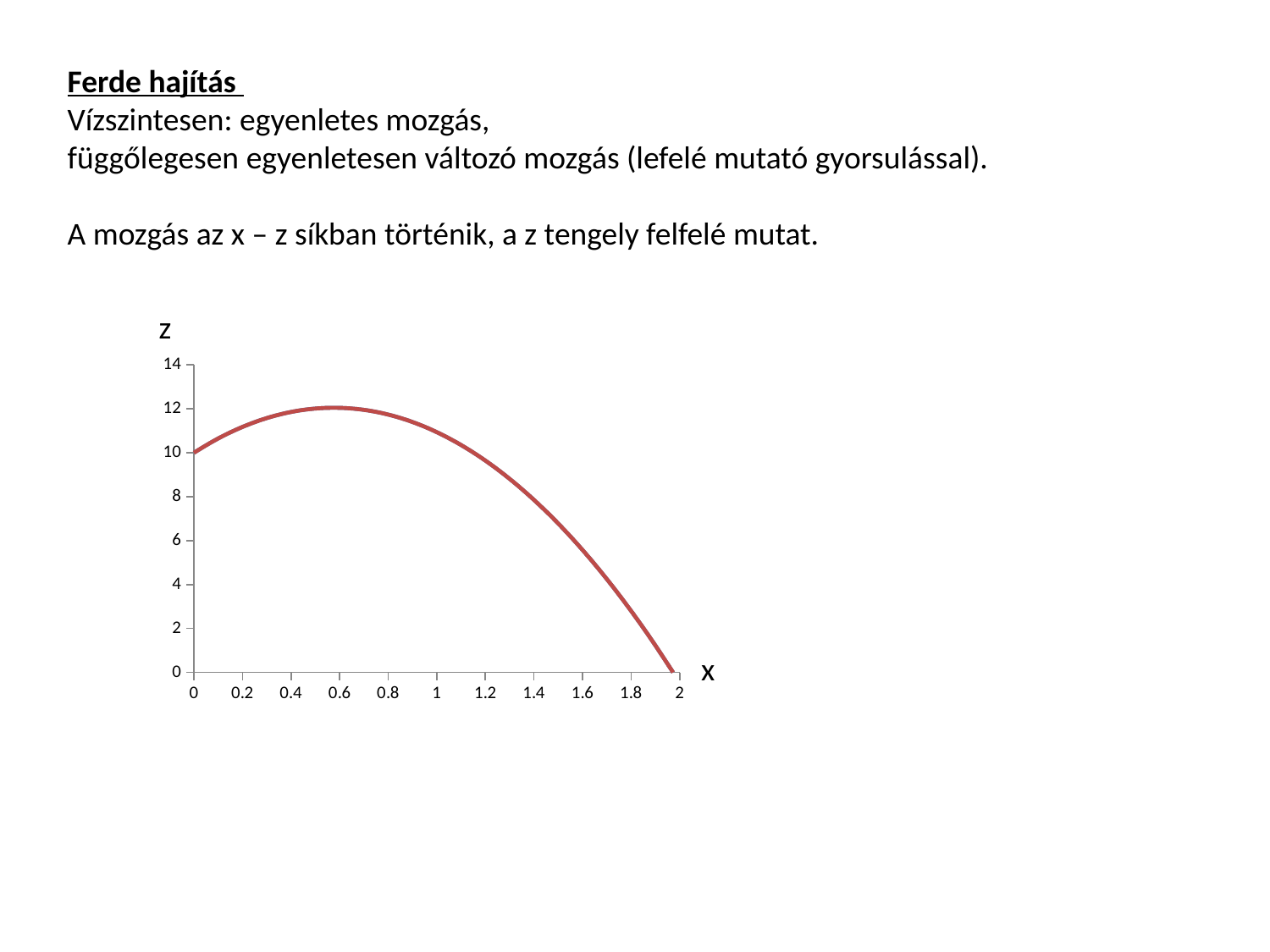
Is the highest value of z on the curve greater or less than 10? greater What is the label of the vertical axis? z Does the curve rise or fall between x = 0 and x = 0.4? rise Is the value of z at x = 1 greater or less than 8? greater What is the value of z at x = 0? 10 Which is larger, the value of z at x = 0.6 or at x = 1.4? x = 0.6 Is the value of z at x = 1.8 greater or less than 4? less What kind of chart is shown on the slide? line chart What is the highest tick value shown on the vertical axis? 14 Does the curve rise or fall between x = 1 and x = 1.8? fall